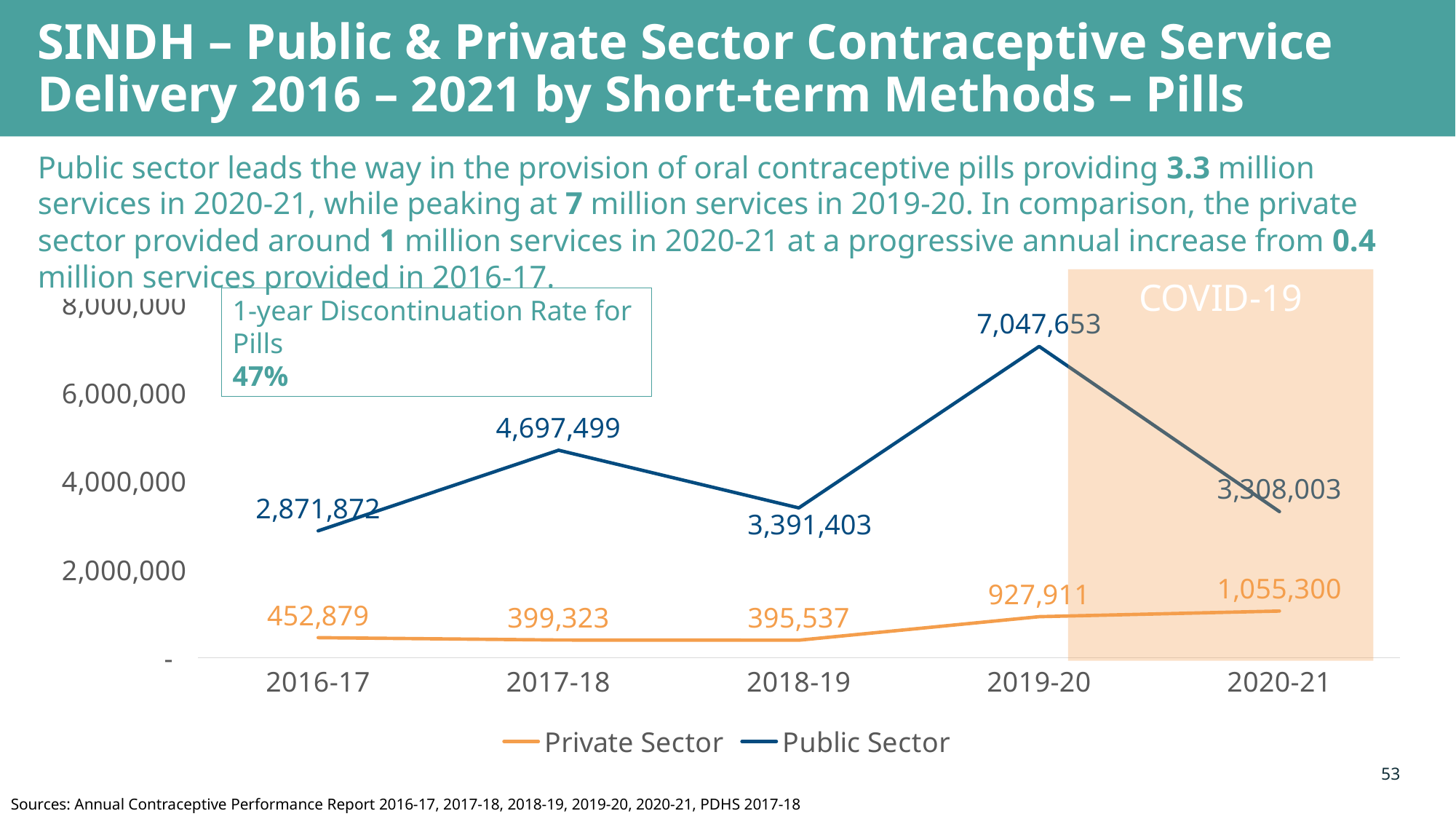
In which year is the Private Sector value lowest? 2018-19 What is the Private Sector value for 2016-17? 452,879 How many years are plotted on the x axis? 5 What is the Public Sector value for 2019-20? 7,047,653 What is the Public Sector value for 2020-21? 3,308,003 By how much did the Private Sector value increase from 2016-17 to 2020-21? 602,421 What is the difference between the Public Sector and Private Sector values in 2019-20? 6,119,742 Which is larger, the Public Sector value in 2017-18 or in 2018-19? 2017-18 In which year does the Public Sector reach its highest value? 2019-20 What kind of chart is shown on the slide? line chart How many series does the legend list? 2 Is the Public Sector value for 2017-18 greater or less than 4,000,000? greater